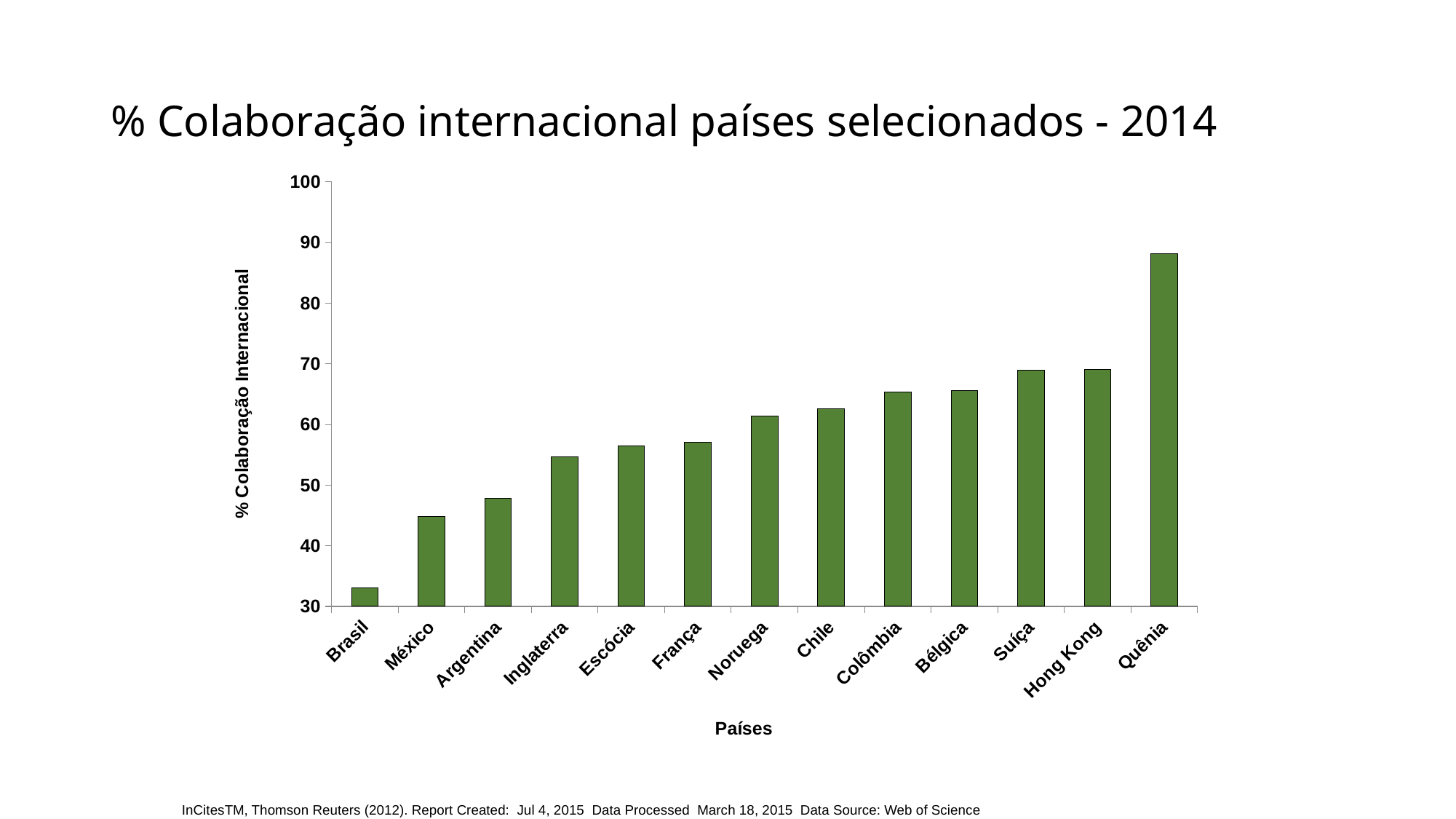
Is the value for Brasil greater or less than 40? less What is the title of the y axis of the chart? % Colaboração Internacional What kind of chart is shown on the slide? bar chart Do the values rise or fall moving from left to right along the x axis? rise Which has a larger value, Brasil or México? México Which has a larger value, Quênia or Hong Kong? Quênia Is the value for Quênia greater or less than 80? greater Is the value for Noruega greater or less than 60? greater How many countries are shown on the x axis of the chart? 13 Which country has the highest % Colaboração Internacional? Quênia Which country has the lowest % Colaboração Internacional? Brasil